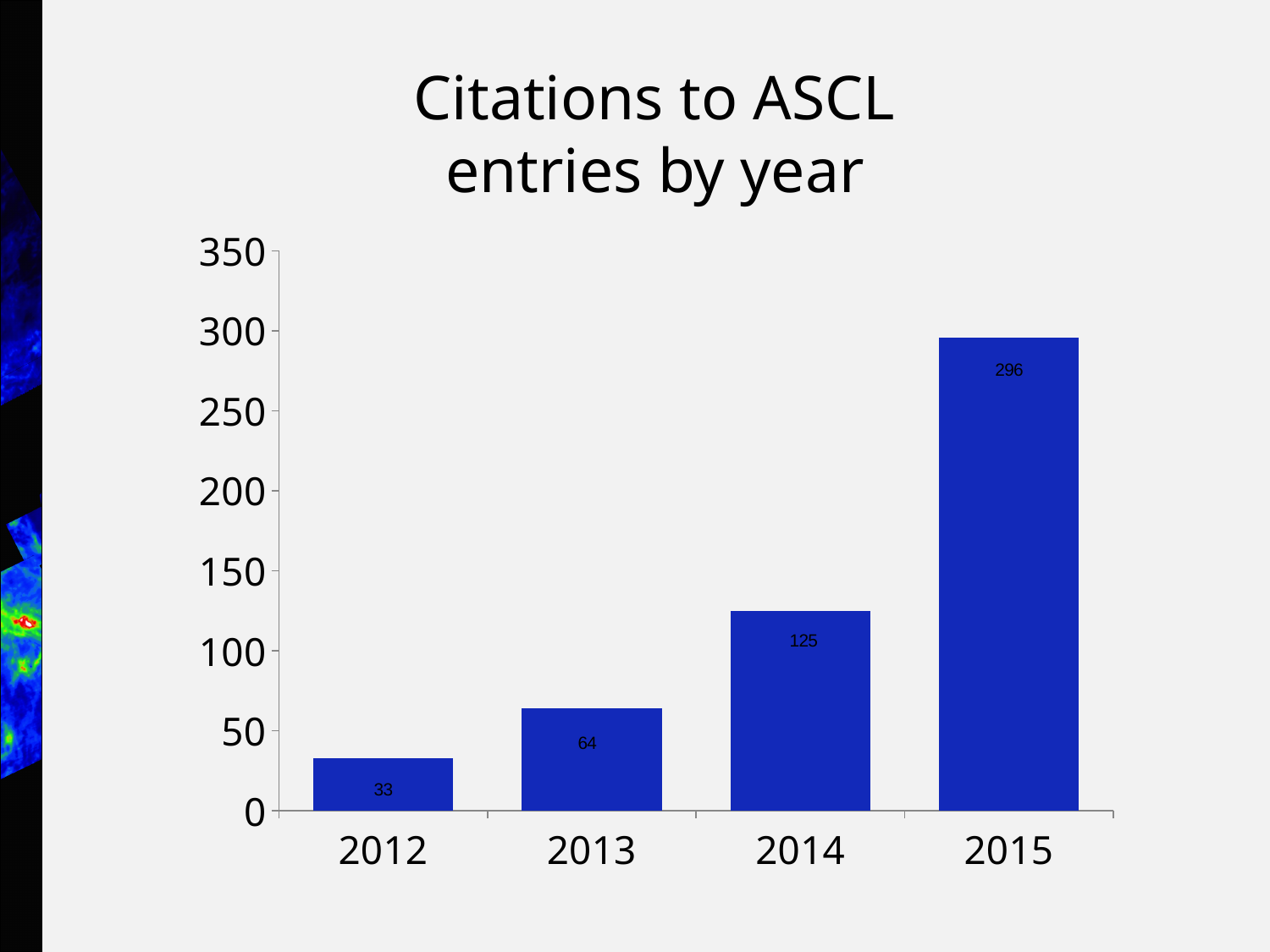
How many years are shown on the x axis? 4 What is the value for 2012? 33 Which year has the highest number of citations? 2015 What is the value for 2015? 296 What is the value for 2014? 125 Do the values rise or fall from 2012 to 2015? rise What is the value for 2013? 64 What kind of chart is this? bar chart Which is larger, the value for 2013 or the value for 2014? 2014 What is the difference between the values for 2015 and 2014? 171 Which year has the lowest number of citations? 2012 Is the value for 2015 greater or less than 250? greater